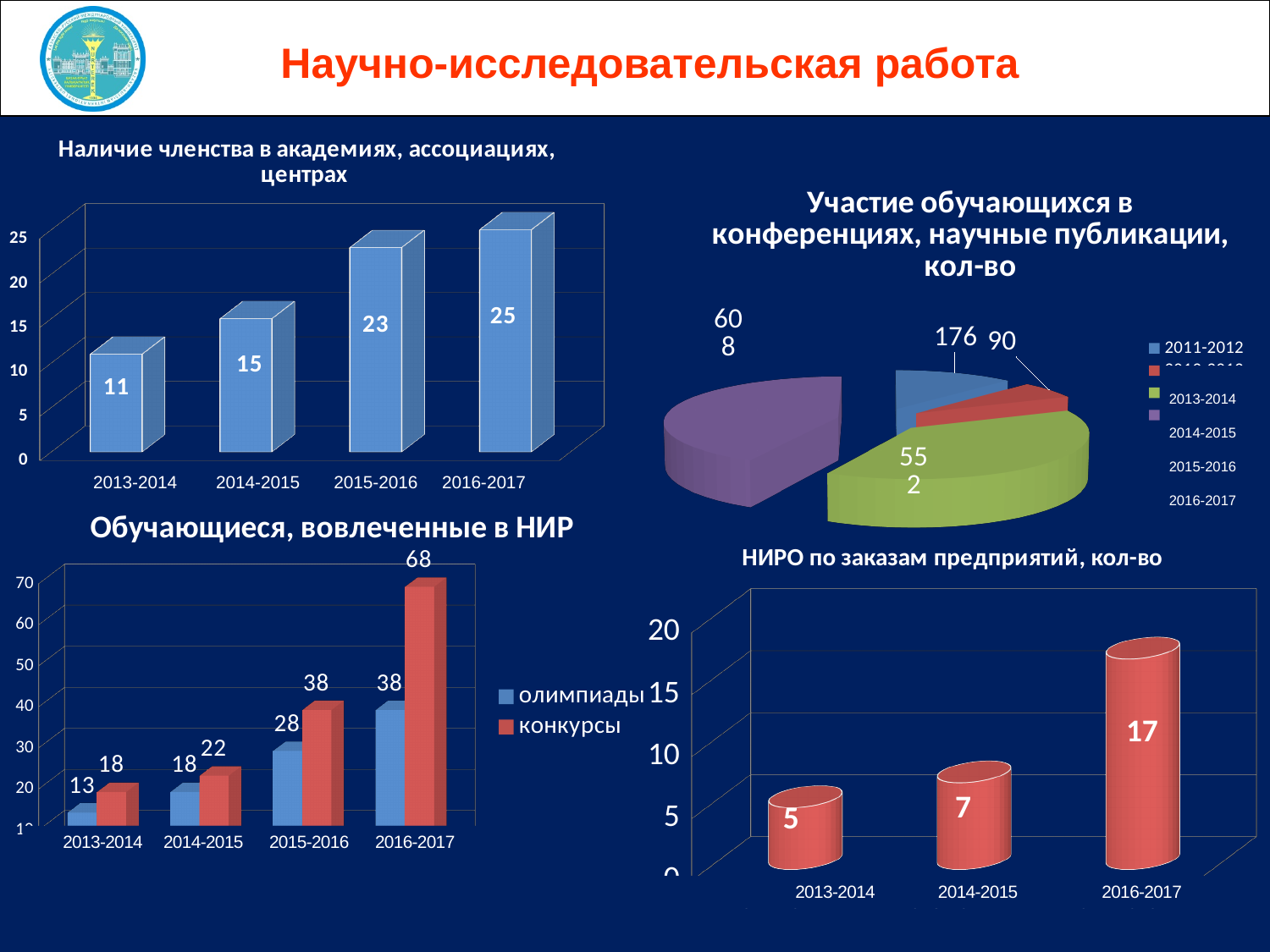
In the chart 'НИРО по заказам предприятий, кол-во', what is the value for 2014-2015? 7 In the chart 'Наличие членства в академиях, ассоциациях, центрах', do the values rise or fall from 2013-2014 to 2016-2017? rise In the chart 'Обучающиеся, вовлеченные в НИР', what is the difference between конкурсы and олимпиады in 2016-2017? 30 What kind of chart is 'Участие обучающихся в конференциях, научные публикации, кол-во'? pie chart In the chart 'Обучающиеся, вовлеченные в НИР', what is the value for олимпиады in 2015-2016? 28 In the chart 'Обучающиеся, вовлеченные в НИР', how many series does the legend list? 2 In the chart 'Наличие членства в академиях, ассоциациях, центрах', what is the difference between the values for 2016-2017 and 2013-2014? 14 How many categories are shown in the chart 'НИРО по заказам предприятий, кол-во'? 3 In the chart 'Обучающиеся, вовлеченные в НИР', which is larger in 2014-2015: олимпиады or конкурсы? конкурсы In the chart 'Наличие членства в академиях, ассоциациях, центрах', which category has the lowest value? 2013-2014 In the chart 'Наличие членства в академиях, ассоциациях, центрах', what is the value for 2015-2016? 23 In the chart 'Обучающиеся, вовлеченные в НИР', what is the value for конкурсы in 2016-2017? 68